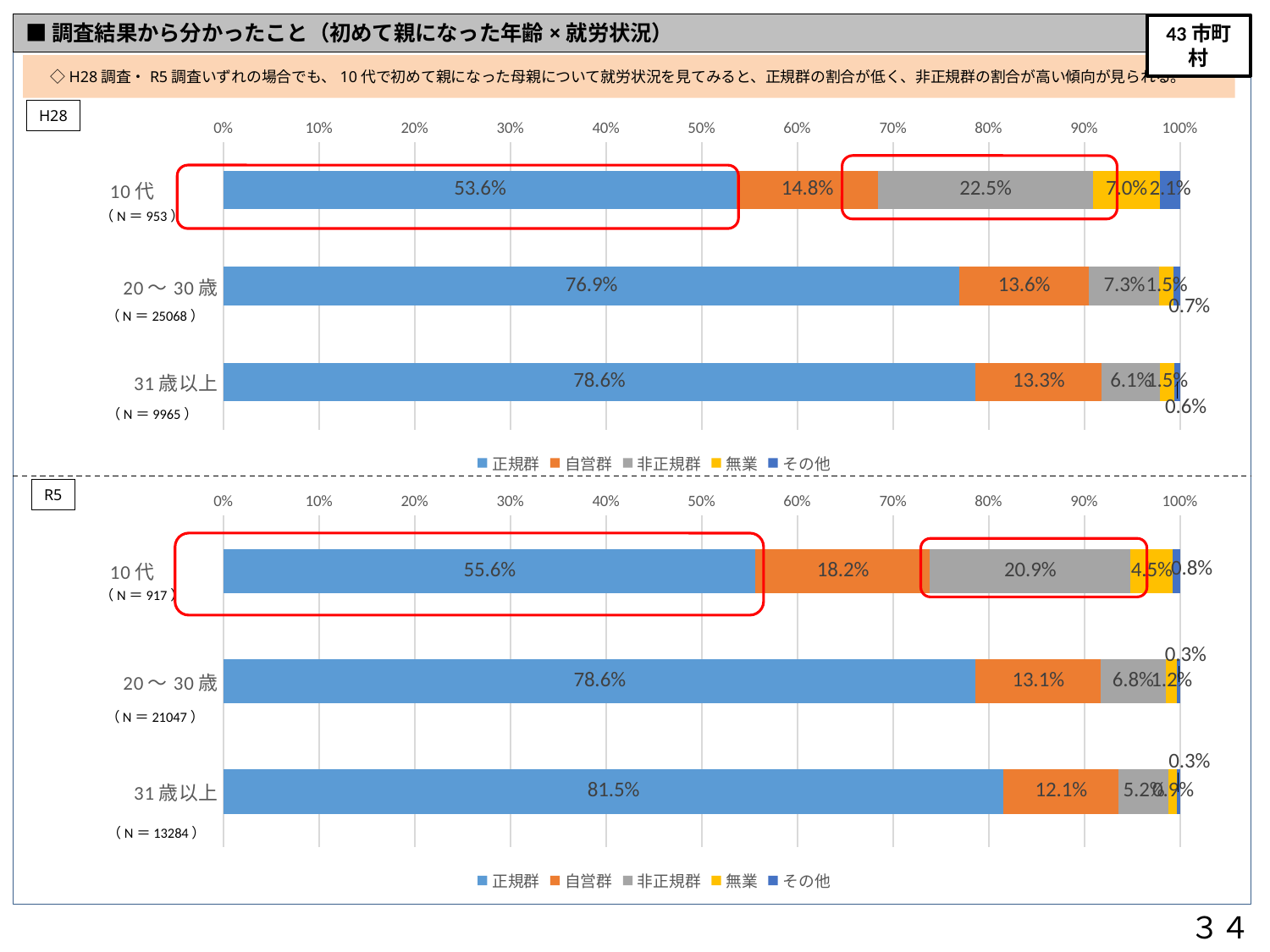
In the H28 chart, what is the 正規群 value for 10代? 53.6% How many age categories are shown in the R5 chart? 3 In the H28 chart, what is the difference between the 正規群 values for 31歳以上 and 10代? 25.0% What kind of chart is the H28 chart? Stacked bar chart In the R5 chart, which age category has the lowest 正規群 value? 10代 In the R5 chart, is the 非正規群 value for 10代 larger or smaller than the 非正規群 value for 20〜30歳? larger How many series does the legend of the H28 chart list? 5 In the R5 chart, what is the 正規群 value for 31歳以上? 81.5% In the R5 chart, what is the 自営群 value for 10代? 18.2% In the R5 chart, what is the difference between the 非正規群 values for 10代 and 31歳以上? 15.7% In the H28 chart, what is the 非正規群 value for 10代? 22.5% In the H28 chart, which age category has the highest 正規群 value? 31歳以上